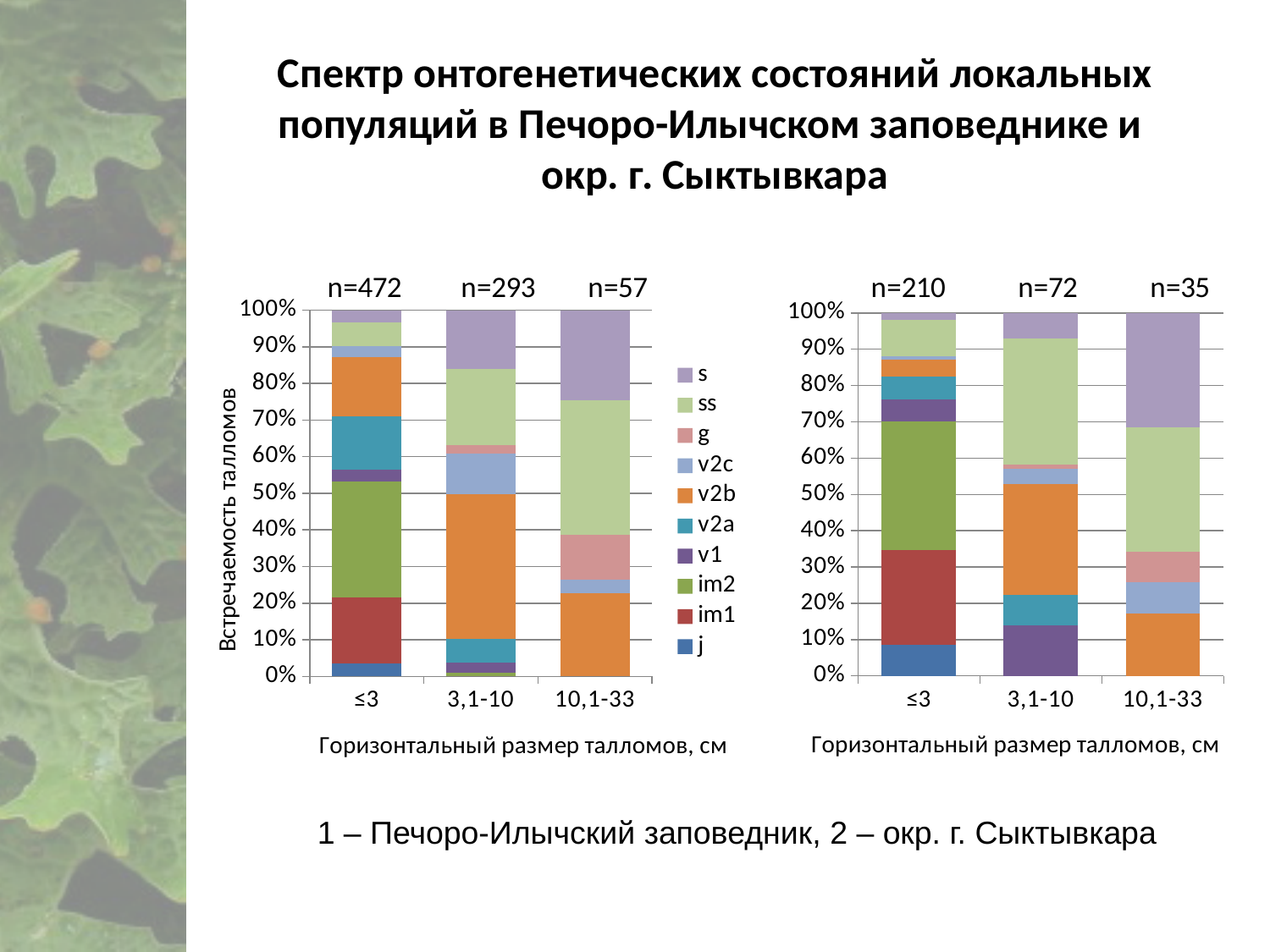
What kind of chart is the left chart? stacked bar chart How many series does the legend list? 10 What is the x-axis title of the left chart? Горизонтальный размер талломов, см In the right chart, is the share of the 'im2' series for ≤3 greater or less than 30%? greater In the right chart, what sample size (n) is printed above the 10,1-33 bar? n=35 In the left chart, is the share of the 's' series for 10,1-33 greater or less than 20%? greater How many categories are shown on the x axis of the right chart? 3 In the right chart, which category has the largest share of the 'v2b' series? 3,1-10 In the left chart, which category has the largest share of the 's' series? 10,1-33 In the right chart, which category has the largest share of the 's' series? 10,1-33 In the left chart, is the share of the 'j' series for ≤3 greater or less than 10%? less